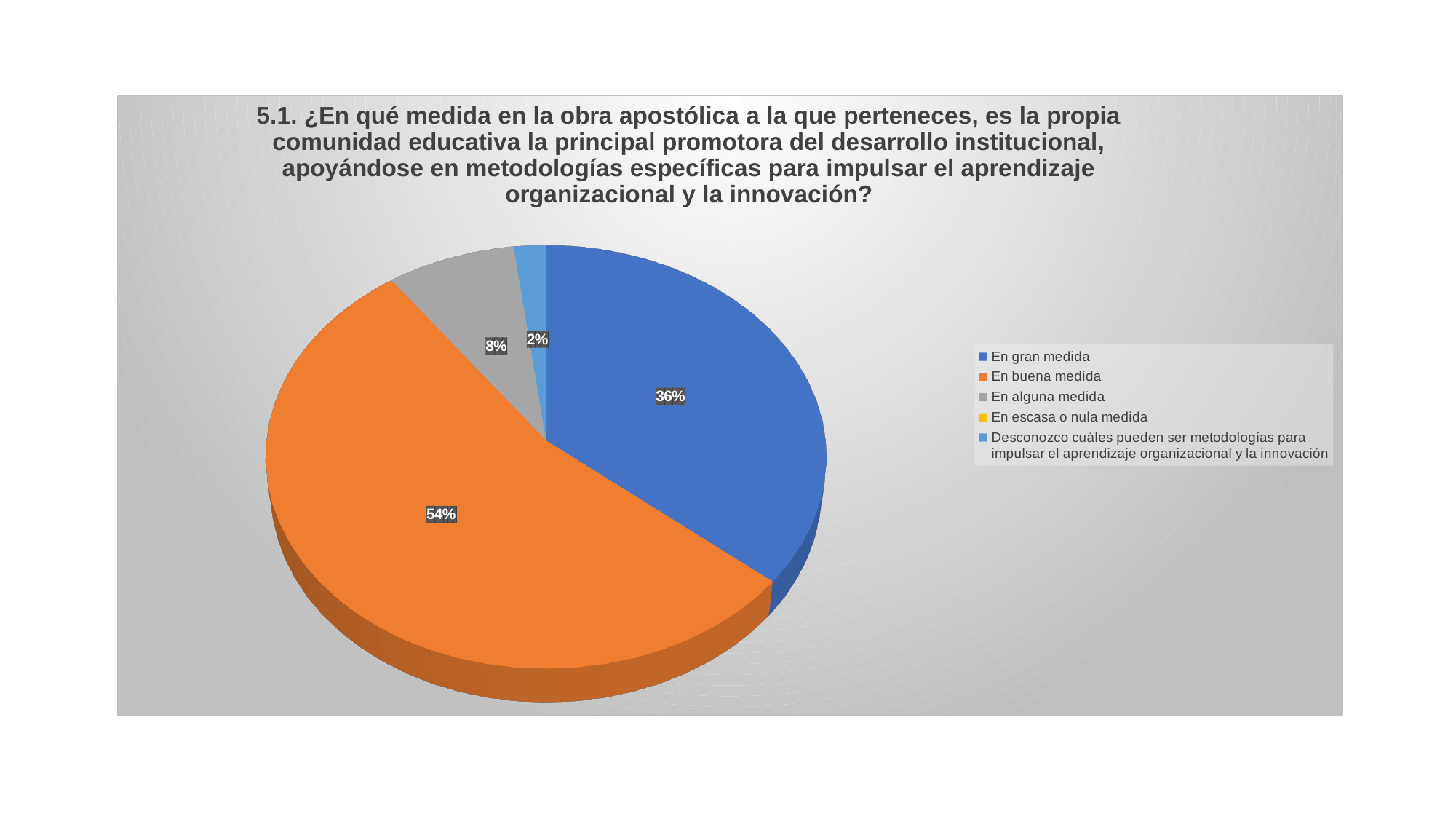
What colour is the slice for "En buena medida"? Orange What percentage of the pie is labelled for "En gran medida"? 36% What is the difference in percentage points between "En buena medida" and "En gran medida"? 18 How many categories does the legend list? 5 What kind of chart is shown on the slide? Pie chart Which category has the largest slice of the pie? En buena medida Which legend entry is shown in yellow? En escasa o nula medida What percentage of the pie is labelled for "En buena medida"? 54% Which labelled slice is the smallest in the pie? Desconozco cuáles pueden ser metodologías para impulsar el aprendizaje organizacional y la innovación Which is larger, the slice for "En gran medida" or the slice for "En alguna medida"? En gran medida What percentage is shown for the slice "Desconozco cuáles pueden ser metodologías para impulsar el aprendizaje organizacional y la innovación"? 2% What percentage of the pie is labelled for "En alguna medida"? 8%